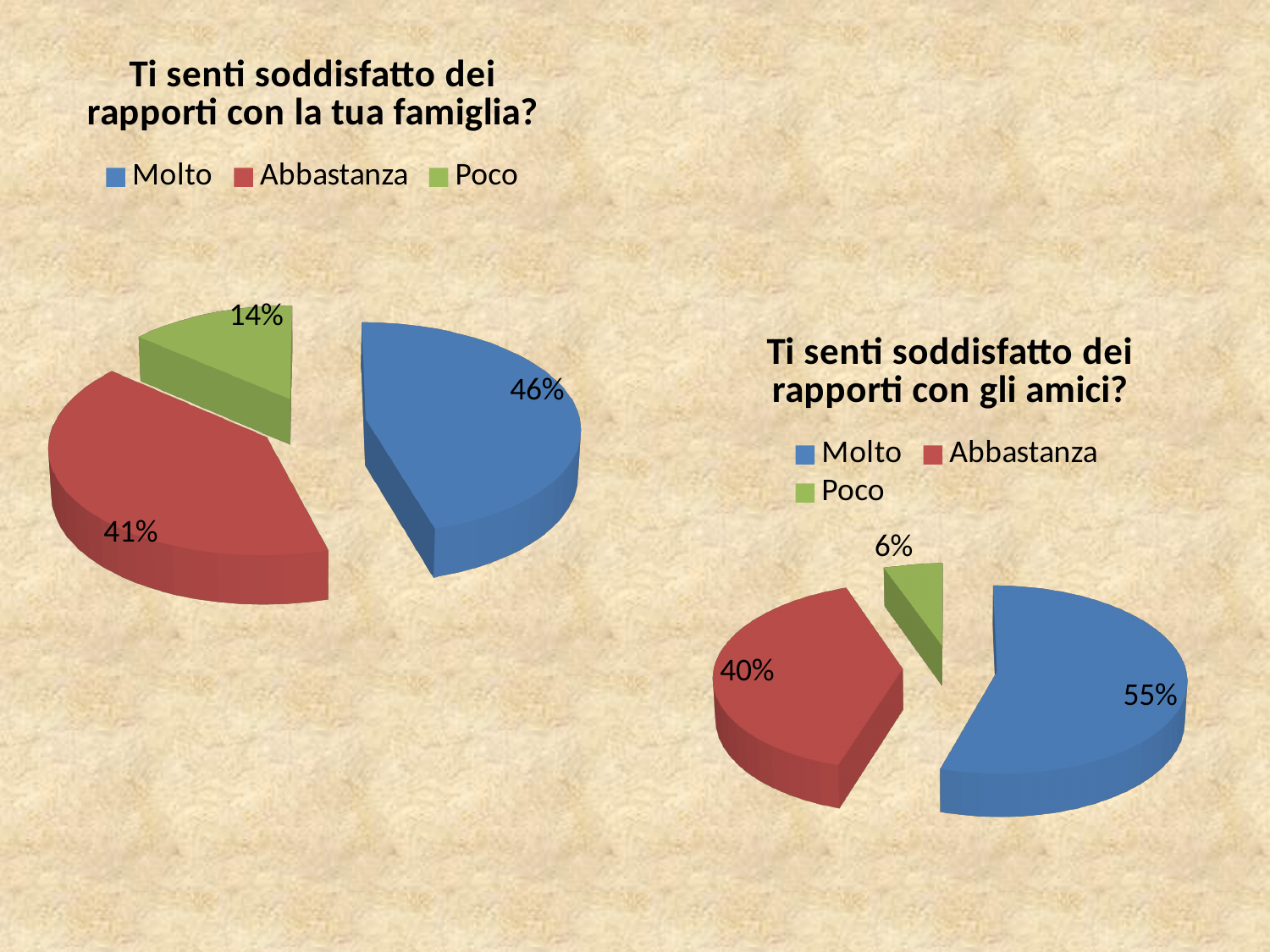
In the chart titled "Ti senti soddisfatto dei rapporti con gli amici?", what colour represents Abbastanza? Red In the chart titled "Ti senti soddisfatto dei rapporti con gli amici?", what is the difference in percentage points between Molto and Poco? 49 In the chart titled "Ti senti soddisfatto dei rapporti con la tua famiglia?", what percentage is shown for Molto? 46% In the chart titled "Ti senti soddisfatto dei rapporti con la tua famiglia?", what is the difference in percentage points between Molto and Abbastanza? 5 In the chart titled "Ti senti soddisfatto dei rapporti con gli amici?", what percentage is shown for Abbastanza? 40% What type of chart is used in the chart titled "Ti senti soddisfatto dei rapporti con gli amici?"? Pie chart In the chart titled "Ti senti soddisfatto dei rapporti con gli amici?", which category has the smallest slice? Poco In the chart titled "Ti senti soddisfatto dei rapporti con la tua famiglia?", what percentage is shown for Poco? 14% In the chart titled "Ti senti soddisfatto dei rapporti con gli amici?", what percentage is shown for Poco? 6% Which chart has the larger share for Molto: the family chart on the left or the friends chart on the right? The friends chart on the right How many categories does the legend list in the chart titled "Ti senti soddisfatto dei rapporti con la tua famiglia?"? 3 In the chart titled "Ti senti soddisfatto dei rapporti con la tua famiglia?", which category has the largest slice? Molto